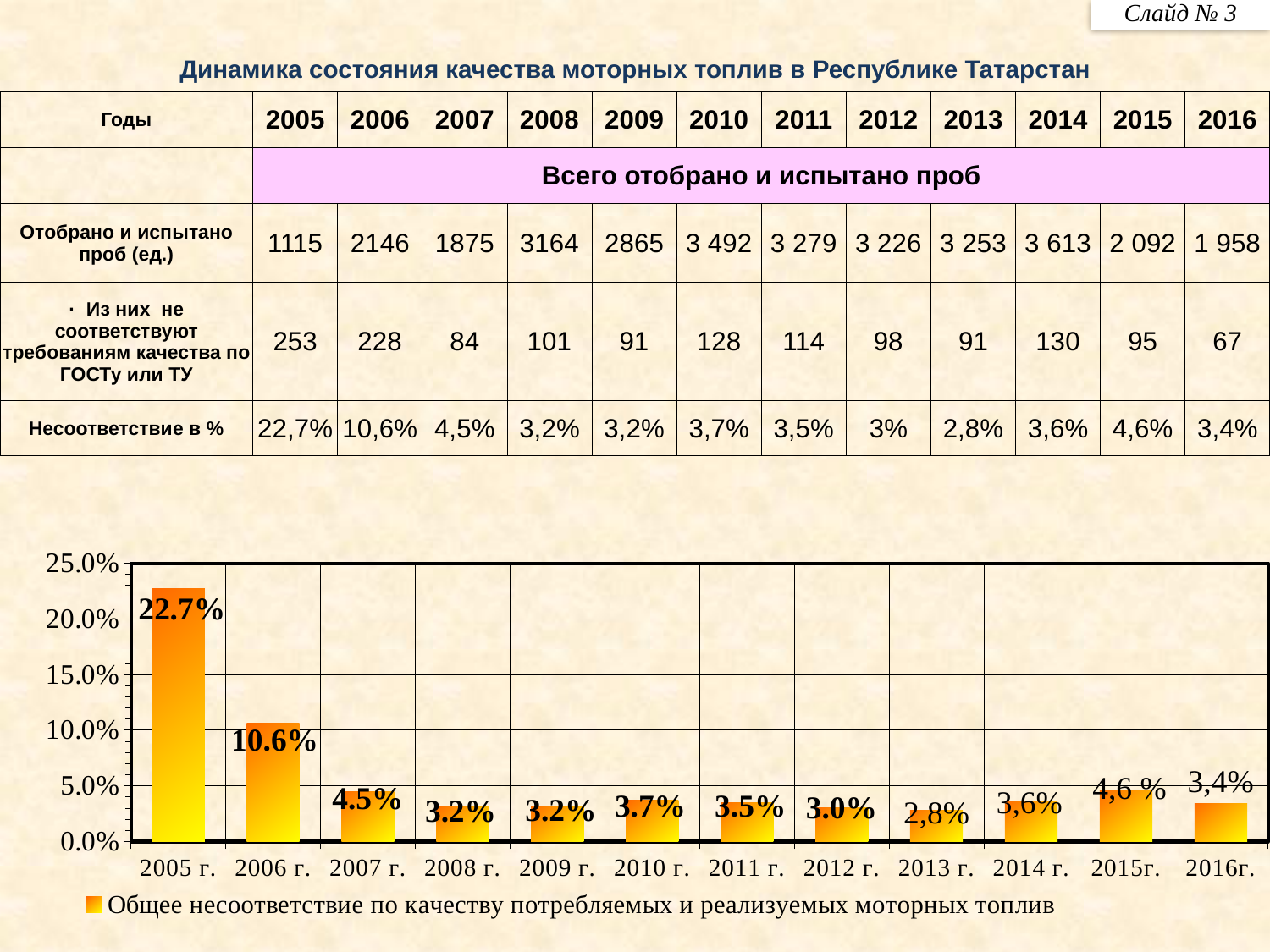
Which year has the highest bar in the chart? 2005 г. What is the value shown for 2005 г. in the bar chart? 22.7% How many series does the legend of the bar chart list? 1 Is the value for 2006 г. in the bar chart greater or less than 10.0%? greater What type of chart is shown on the slide? bar chart What is the value shown for 2006 г. in the bar chart? 10.6% What is the value shown for 2010 г. in the bar chart? 3.7% What is the difference between the values for 2005 г. and 2006 г. in the bar chart? 12.1% Which year has the lowest bar in the chart? 2013 г. What is the value shown for 2014 г. in the bar chart? 3,6% Which is larger in the bar chart, the value for 2007 г. or the value for 2008 г.? 2007 г. How many years (bars) are plotted in the bar chart? 12